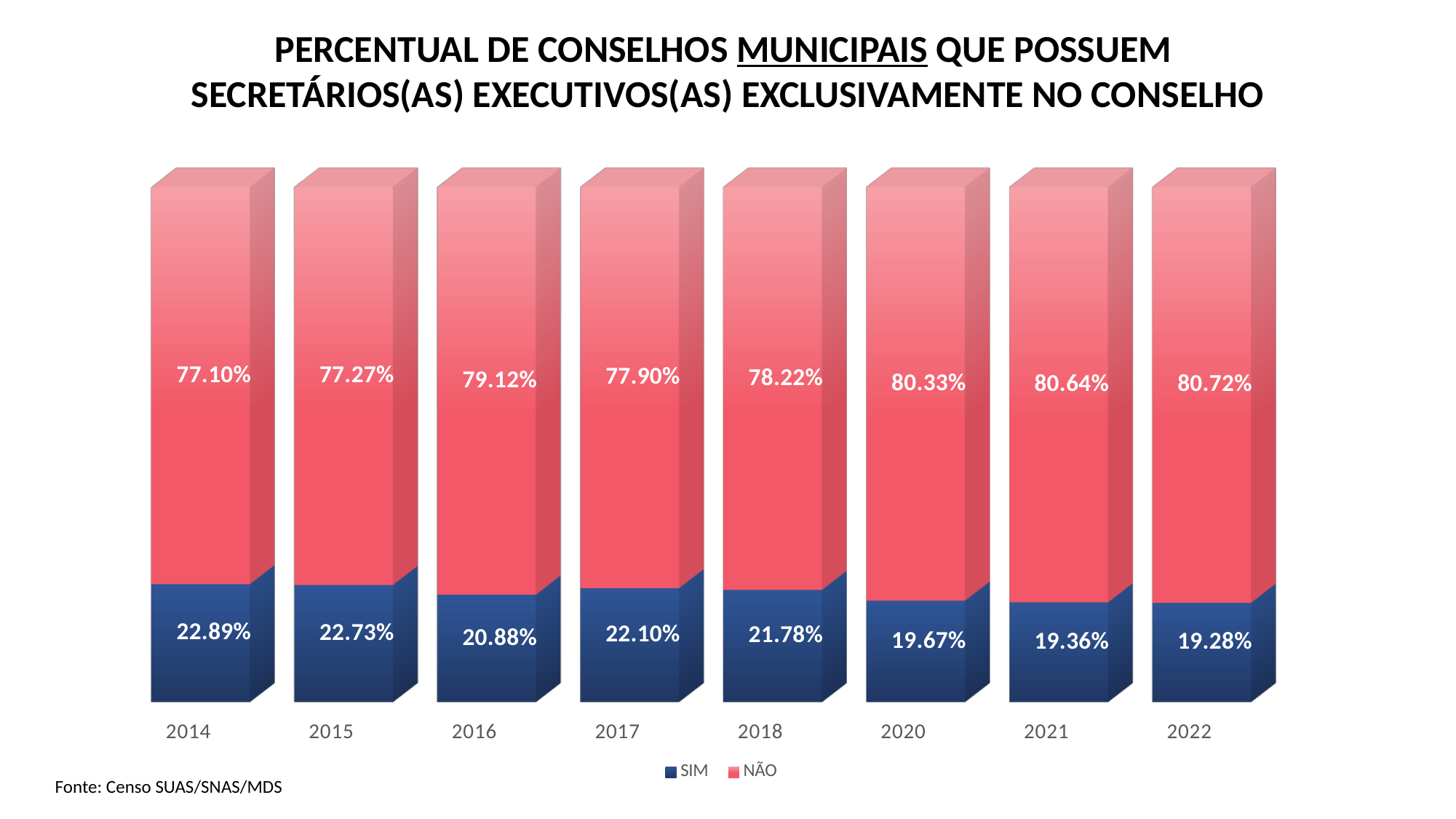
What kind of chart is shown on the slide? Stacked bar chart Does the SIM value generally rise or fall from 2014 to 2022? Fall What is the SIM value for 2014? 22.89% Which year has the lowest SIM value? 2022 Which year has the highest NÃO value? 2022 What is the difference between the NÃO value in 2022 and the NÃO value in 2014? 3.62 percentage points What is the NÃO value for 2022? 80.72% What is the SIM value for 2018? 21.78% Which is larger, the SIM value for 2016 or the SIM value for 2017? 2017 Which year has the highest SIM value? 2014 How many years are shown on the x axis? 8 How many series does the legend list? 2